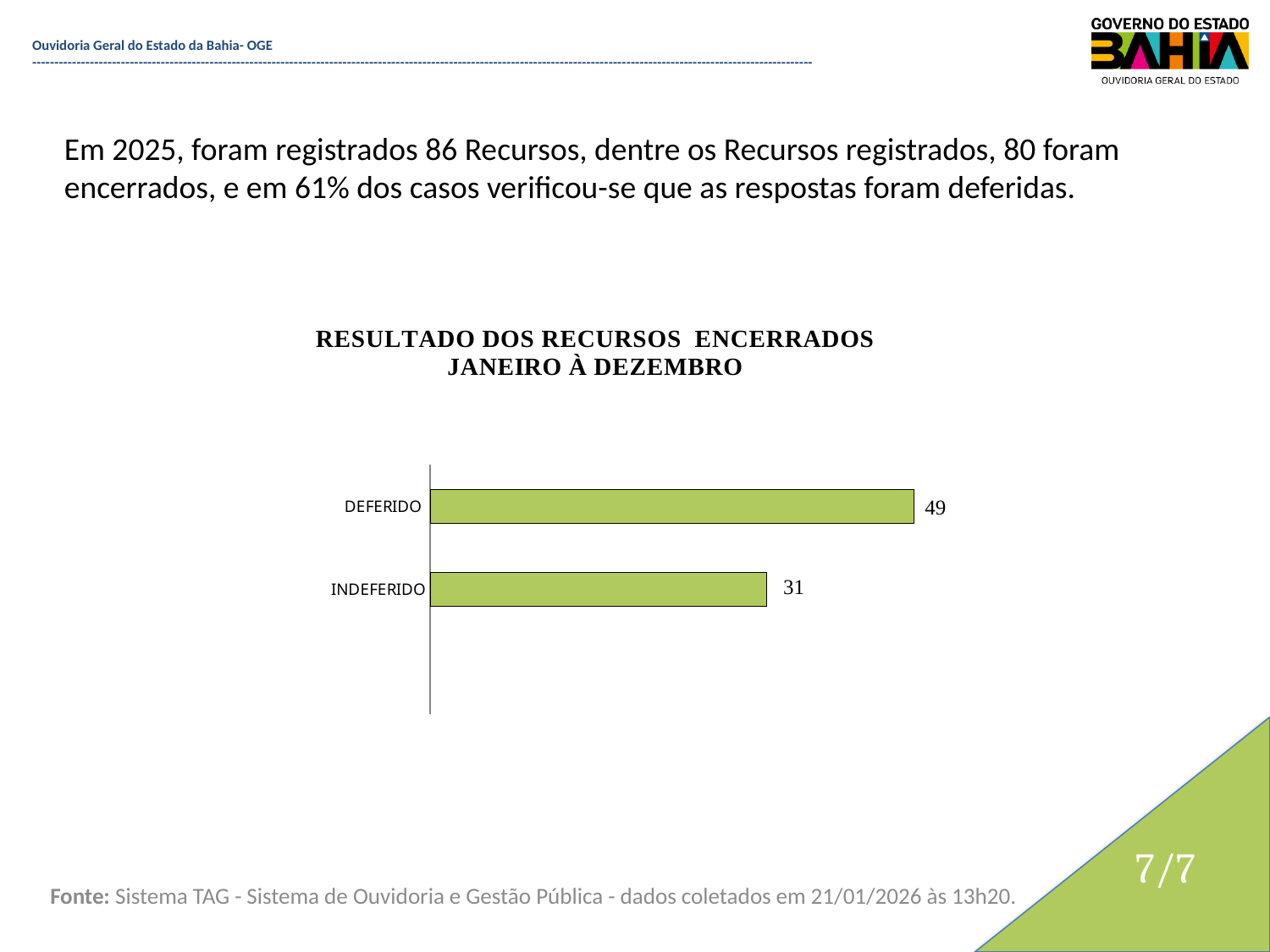
What colour are the bars in the chart? green What kind of chart is shown on the slide? bar chart What is the value for DEFERIDO? 49 What is the title of the chart? RESULTADO DOS RECURSOS ENCERRADOS JANEIRO À DEZEMBRO Which is larger, the value for DEFERIDO or the value for INDEFERIDO? DEFERIDO What is the difference between the values for DEFERIDO and INDEFERIDO? 18 What is the value for INDEFERIDO? 31 Which category has the highest value? DEFERIDO How many categories are shown in the chart? 2 What is the total of the values for DEFERIDO and INDEFERIDO? 80 Which category has the lowest value? INDEFERIDO